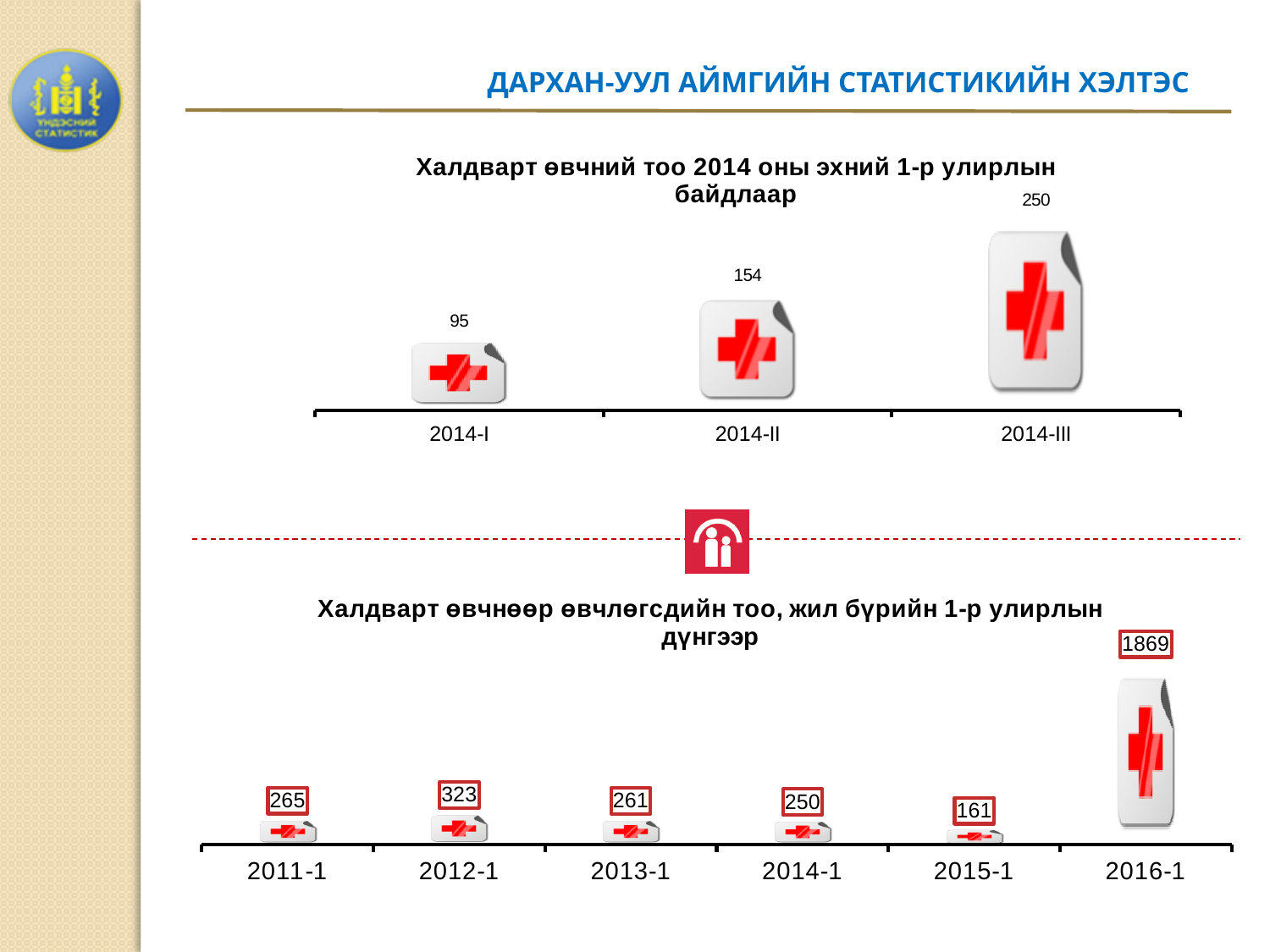
In the top chart, what is the difference between the values for 2014-III and 2014-I? 155 In the bottom chart, what is the difference between the values for 2016-1 and 2015-1? 1708 In the bottom chart, which category has the lowest value? 2015-1 In the top chart, how many categories are shown on the x axis? 3 In the bottom chart, which is larger, the value for 2011-1 or the value for 2013-1? 2011-1 In the bottom chart, how many categories are shown on the x axis? 6 In the top chart, what is the value for 2014-II? 154 In the bottom chart, what is the value for 2016-1? 1869 In the top chart, what is the value for 2014-III? 250 In the bottom chart, what is the value for 2012-1? 323 In the top chart, do the values rise or fall from 2014-I to 2014-III? rise In the top chart, which category has the lowest value? 2014-I